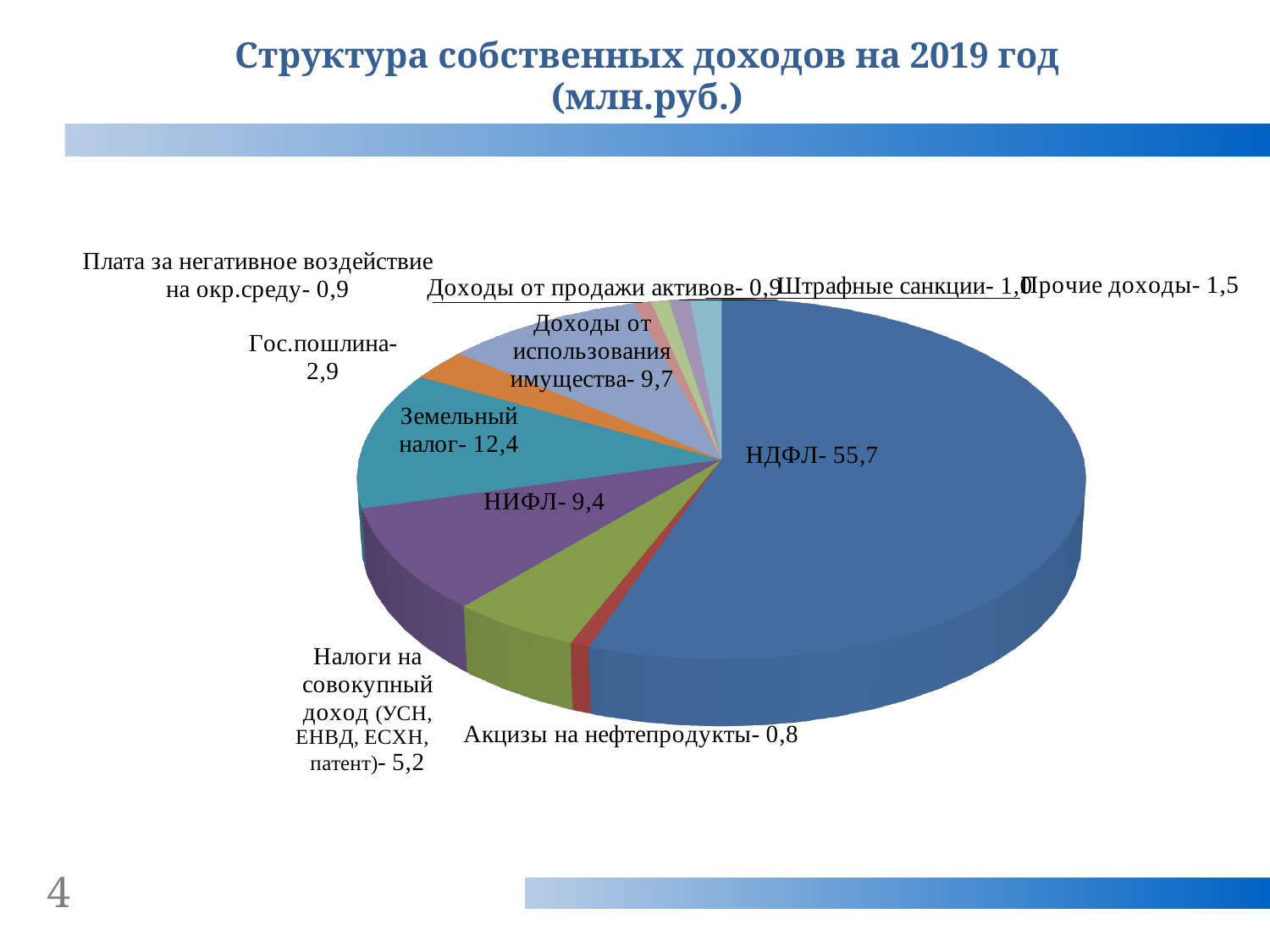
What is the title of the chart on the slide? Структура собственных доходов на 2019 год (млн.руб.) Which category has the smallest value in the pie chart? Акцизы на нефтепродукты What type of chart is shown on the slide? Pie chart What is the value for Доходы от использования имущества? 9,7 What is the value for Гос.пошлина? 2,9 What is the value for НДФЛ in the pie chart? 55,7 What is the value for Земельный налог? 12,4 How many slices does the pie chart have? 11 Which category has the largest slice of the pie? НДФЛ What is the value for Налоги на совокупный доход (УСН, ЕНВД, ЕСХН, патент)? 5,2 What is the difference between the values for НДФЛ and Земельный налог? 43,3 Which is larger: Земельный налог or Доходы от использования имущества? Земельный налог